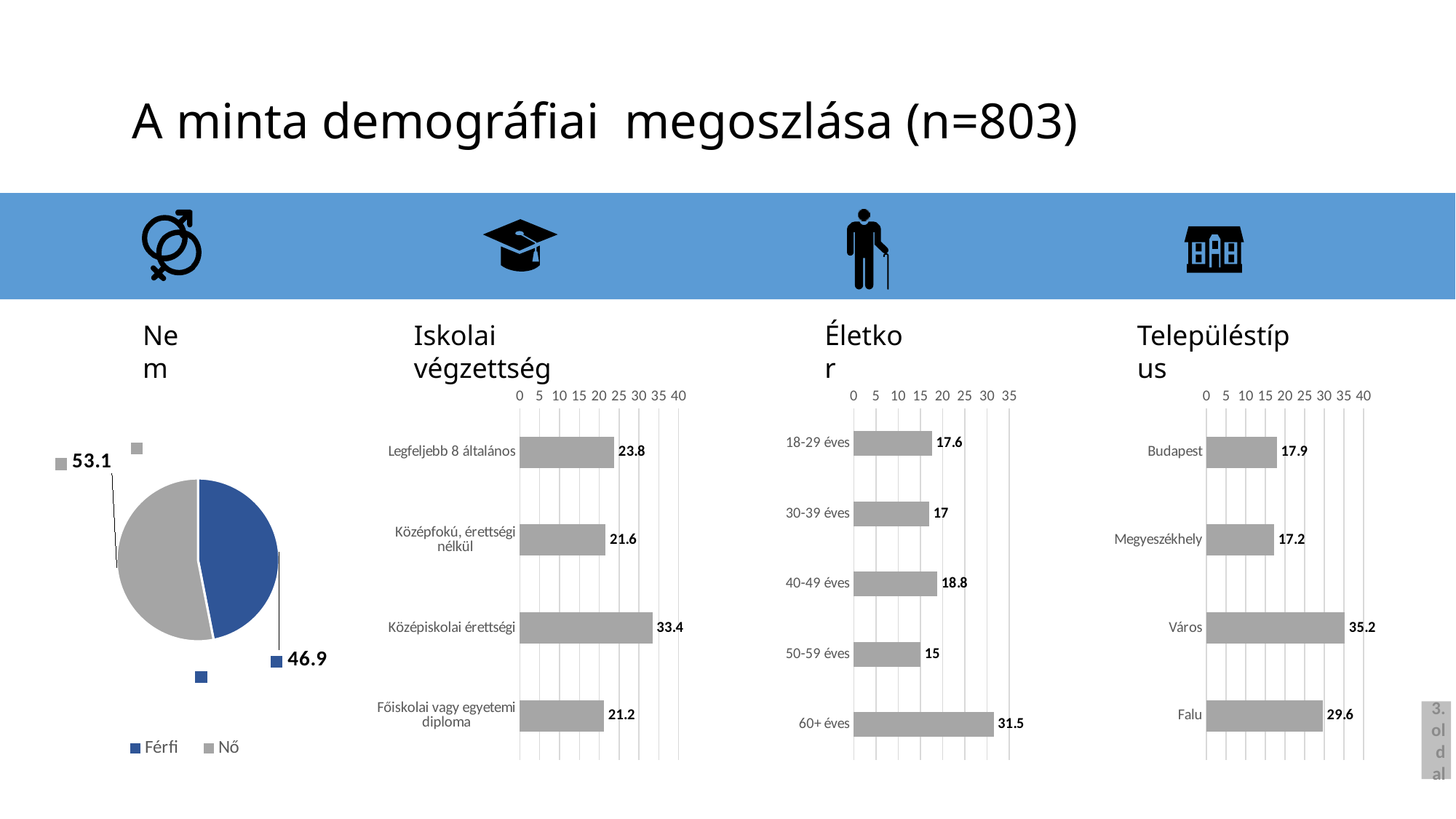
In the 'Településtípus' chart, what is the difference between Város and Falu? 5.6 What kind of chart is the 'Nem' chart? Pie chart In the 'Iskolai végzettség' chart, what is the difference between Legfeljebb 8 általános and Középfokú, érettségi nélkül? 2.2 In the 'Iskolai végzettség' chart, what is the value for Középiskolai érettségi? 33.4 In the 'Településtípus' chart, which category has the highest value? Város In the 'Iskolai végzettség' chart, which category has the lowest value? Főiskolai vagy egyetemi diploma In the 'Életkor' chart, which age group has the lowest value? 50-59 éves In the 'Életkor' chart, what is the value for 60+ éves? 31.5 In the 'Nem' pie chart, what is the value for Férfi? 46.9 How many categories does the 'Életkor' chart show? 5 In the 'Nem' pie chart, what is the value for Nő? 53.1 In the 'Nem' pie chart, which slice is larger, Férfi or Nő? Nő